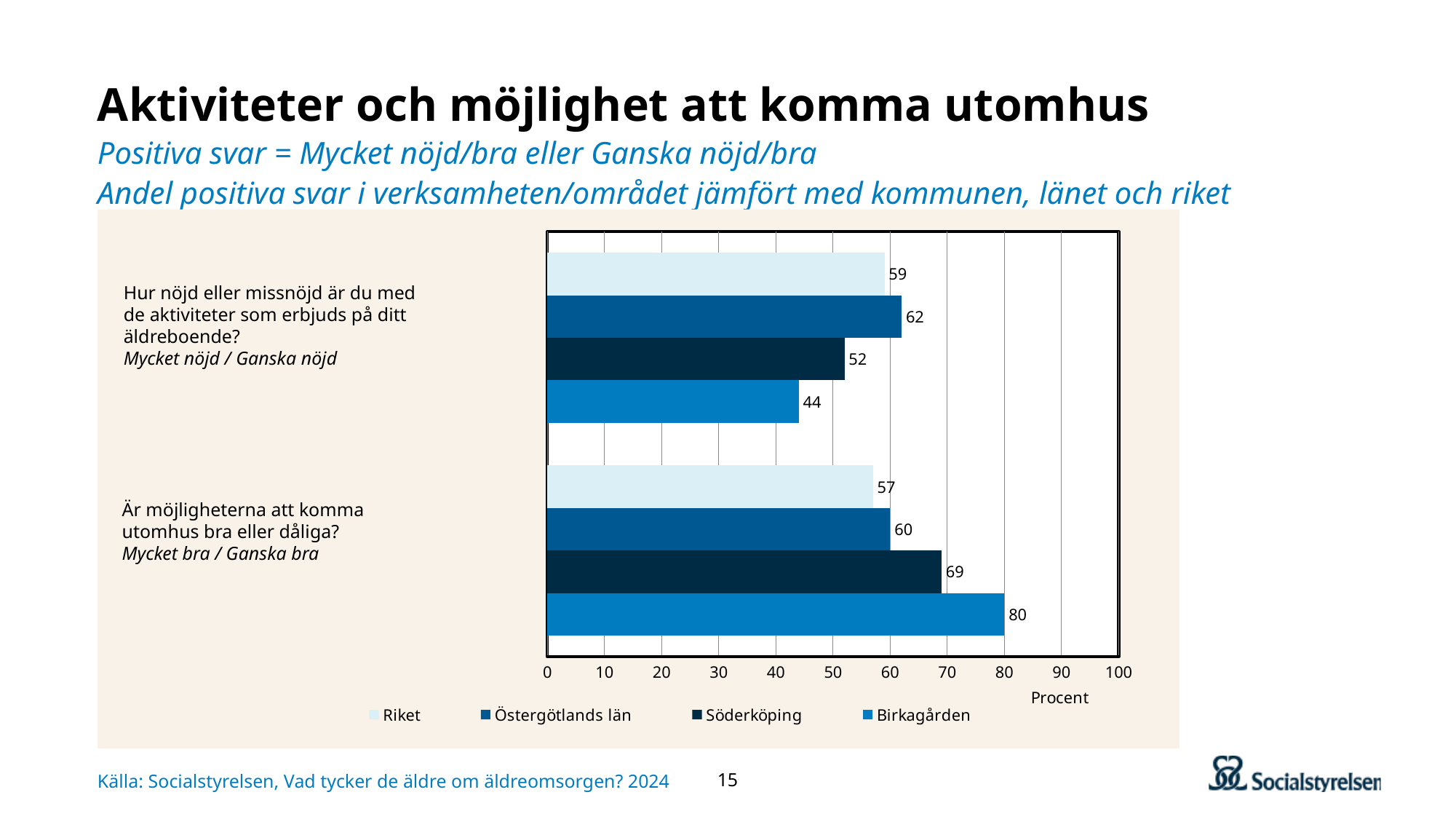
What is the value for Östergötlands län on the question about activities offered at the care home? 62 What is the difference between Östergötlands län and Söderköping on the question about activities offered at the care home? 10 Which series has the lowest value on the question about activities offered at the care home? Birkagården What is the value for Riket on the question about opportunities to get outdoors? 57 What is the difference between Birkagården and Riket on the question about opportunities to get outdoors? 23 What kind of chart is shown on the slide? Bar chart How many series does the legend list? 4 Which is larger: Söderköping's value on the activities question or Söderköping's value on the outdoors question? The outdoors question (69) What is the value for Birkagården on the question about activities offered at the care home ("Hur nöjd eller missnöjd är du med de aktiviteter som erbjuds på ditt äldreboende?")? 44 What is the value for Söderköping on the question about opportunities to get outdoors ("Är möjligheterna att komma utomhus bra eller dåliga?")? 69 Which series has the highest value on the question about opportunities to get outdoors? Birkagården What unit is shown on the horizontal axis of the chart? Procent